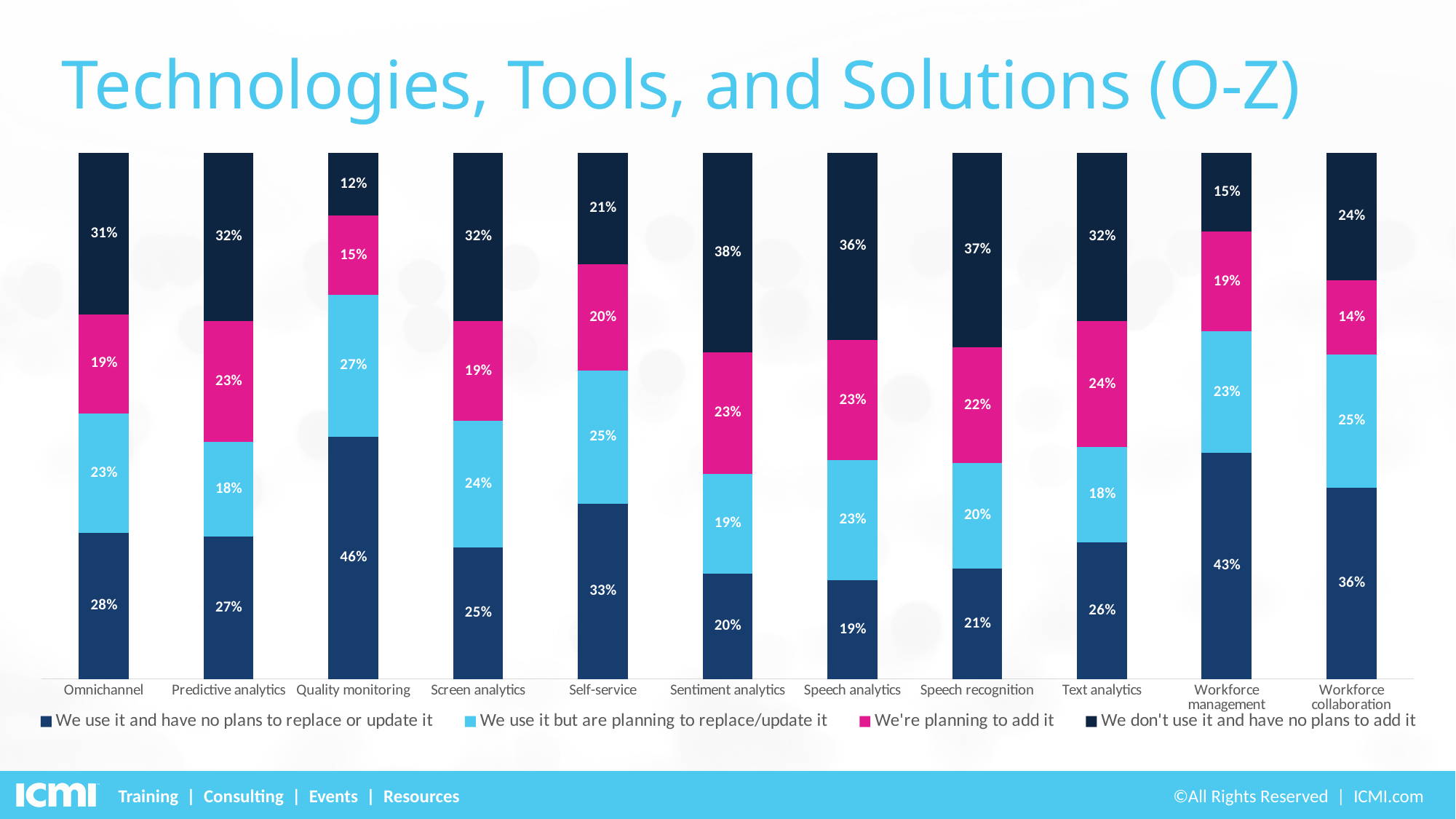
What percentage of respondents for Quality monitoring say they use it and have no plans to replace or update it? 46% What is the value for 'We use it but are planning to replace/update it' for Workforce collaboration? 25% Which technology has the highest value for 'We use it and have no plans to replace or update it'? Quality monitoring Which technology has the lowest value for 'We don't use it and have no plans to add it'? Quality monitoring What is the value for 'We don't use it and have no plans to add it' for Sentiment analytics? 38% Which legend entry is shown in pink? We're planning to add it What kind of chart is shown on the slide? Stacked bar chart Which is larger: the 'We're planning to add it' value for Predictive analytics or for Workforce collaboration? Predictive analytics What is the value for 'We're planning to add it' for Text analytics? 24% How many series does the legend list? 4 What is the difference between the 'We use it and have no plans to replace or update it' values for Workforce management and Speech analytics? 24 percentage points How many technologies are shown on the x axis? 11